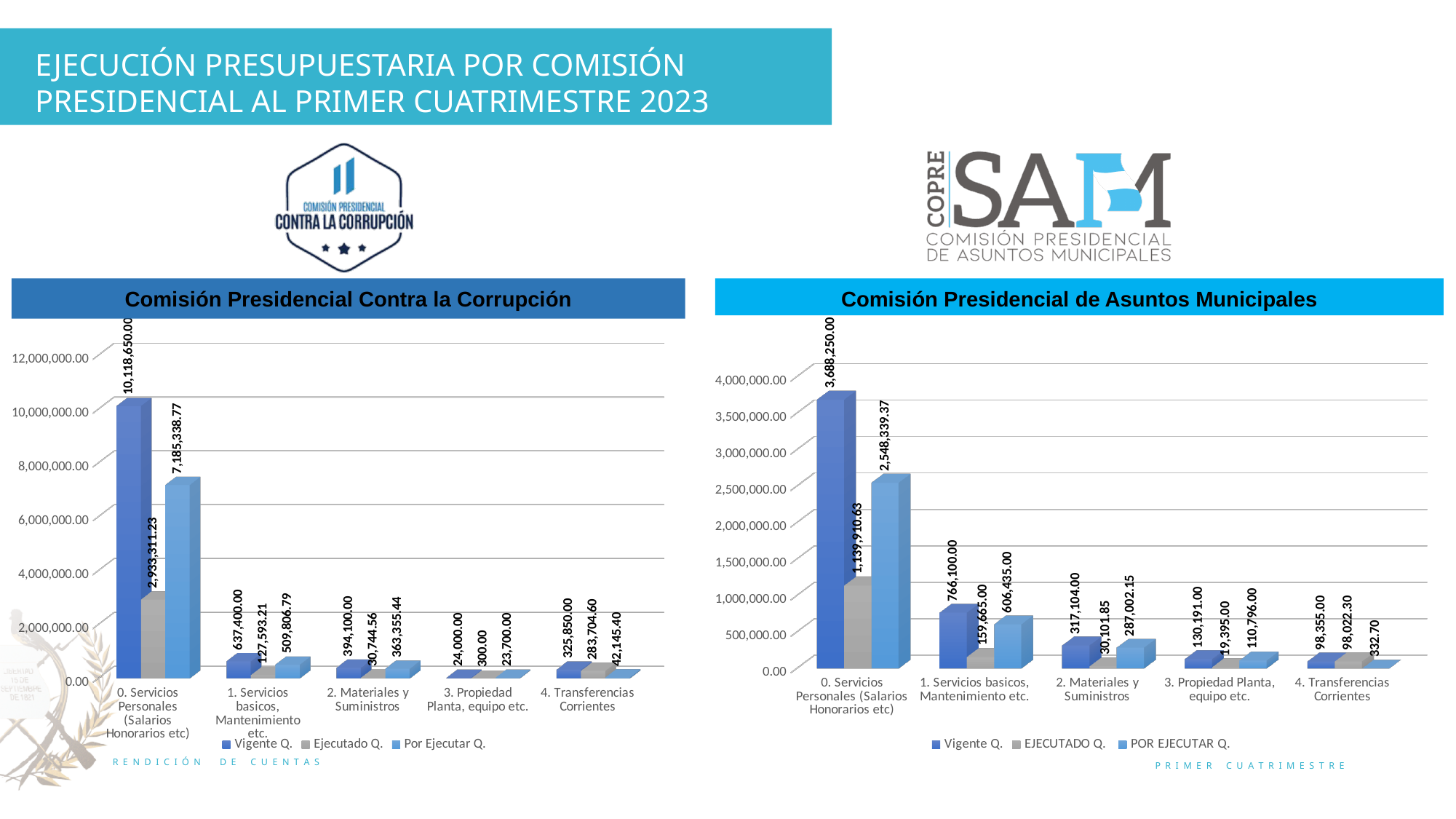
In the 'Comisión Presidencial Contra la Corrupción' chart, which category has the lowest Vigente Q. value? 3. Propiedad Planta, equipo etc. In the 'Comisión Presidencial de Asuntos Municipales' chart, how many categories are shown on the x axis? 5 In the 'Comisión Presidencial Contra la Corrupción' chart, what is the difference between the Vigente Q. and Ejecutado Q. values for '1. Servicios basicos, Mantenimiento etc.'? 509,806.79 What kind of chart is the 'Comisión Presidencial de Asuntos Municipales' chart? Bar chart In the 'Comisión Presidencial de Asuntos Municipales' chart, what is the POR EJECUTAR Q. value for '0. Servicios Personales (Salarios Honorarios etc)'? 2,548,339.37 In the 'Comisión Presidencial de Asuntos Municipales' chart, what is the EJECUTADO Q. value for '2. Materiales y Suministros'? 30,101.85 In the 'Comisión Presidencial Contra la Corrupción' chart, how many series does the legend list? 3 In the 'Comisión Presidencial de Asuntos Municipales' chart, is the Vigente Q. value for '1. Servicios basicos, Mantenimiento etc.' greater or less than 1,000,000.00? less In the 'Comisión Presidencial Contra la Corrupción' chart, what is the Vigente Q. value for '0. Servicios Personales (Salarios Honorarios etc)'? 10,118,650.00 In the 'Comisión Presidencial de Asuntos Municipales' chart, which is larger for '4. Transferencias Corrientes': the EJECUTADO Q. value or the POR EJECUTAR Q. value? EJECUTADO Q. In the 'Comisión Presidencial Contra la Corrupción' chart, what is the Ejecutado Q. value for '4. Transferencias Corrientes'? 283,704.60 In the 'Comisión Presidencial de Asuntos Municipales' chart, which category has the highest Vigente Q. value? 0. Servicios Personales (Salarios Honorarios etc)